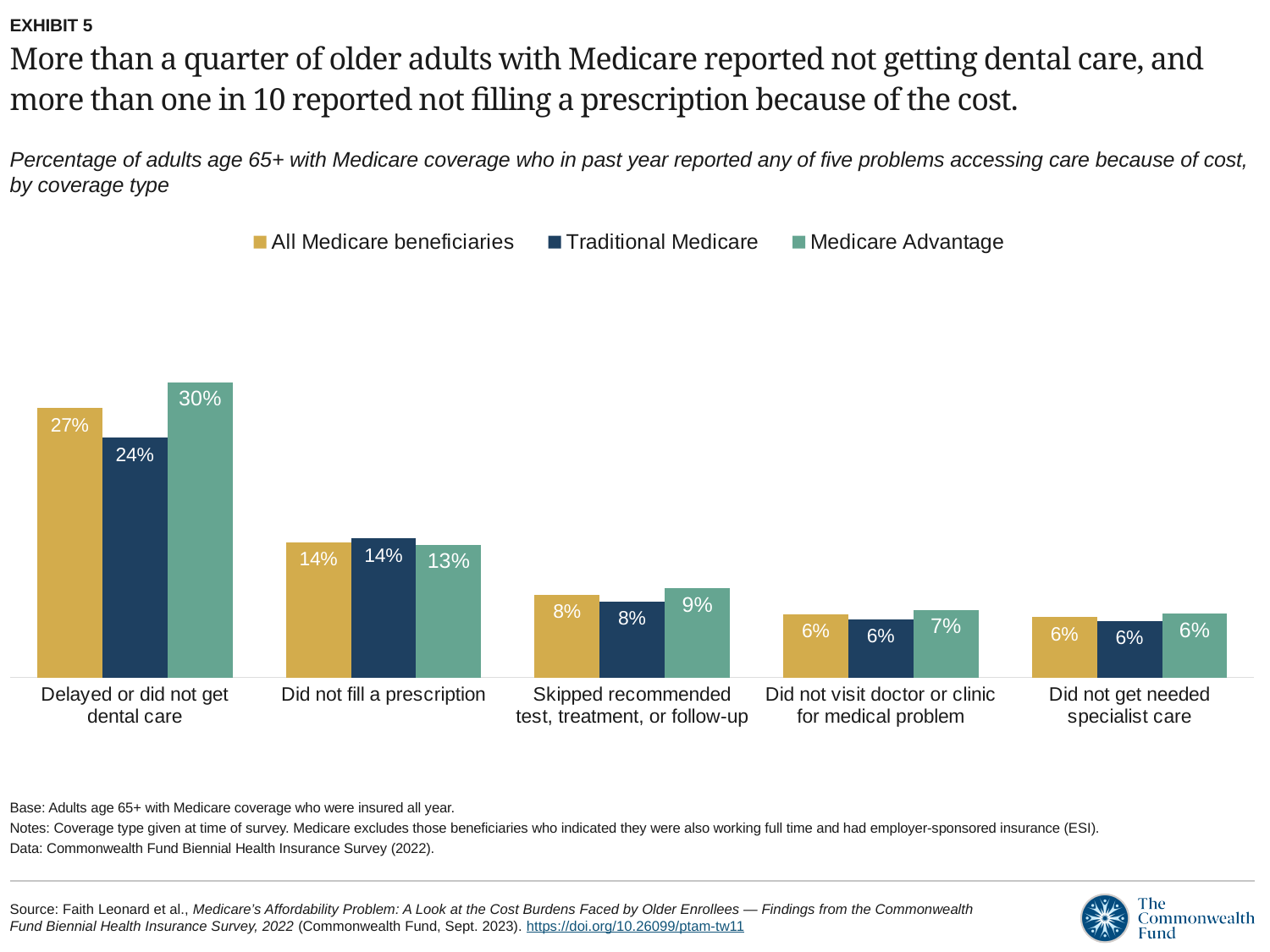
How many problem categories are shown on the x axis? 5 What percentage of Traditional Medicare beneficiaries reported not filling a prescription? 14% What percentage of Medicare Advantage beneficiaries reported delaying or not getting dental care? 30% What is the difference between the Medicare Advantage and Traditional Medicare percentages for delayed or did not get dental care? 6 percentage points Which problem accessing care has the highest percentage for all Medicare beneficiaries? Delayed or did not get dental care For delayed or did not get dental care, which is larger: the Traditional Medicare value or the Medicare Advantage value? Medicare Advantage Do the values for all Medicare beneficiaries rise or fall moving from left to right across the categories? Fall What percentage of Medicare Advantage beneficiaries reported not visiting a doctor or clinic for a medical problem? 7% What percentage of all Medicare beneficiaries reported skipping a recommended test, treatment, or follow-up? 8% What kind of chart is shown on the slide? Bar chart Which series is shown in dark blue in the legend? Traditional Medicare How many series does the legend list? 3